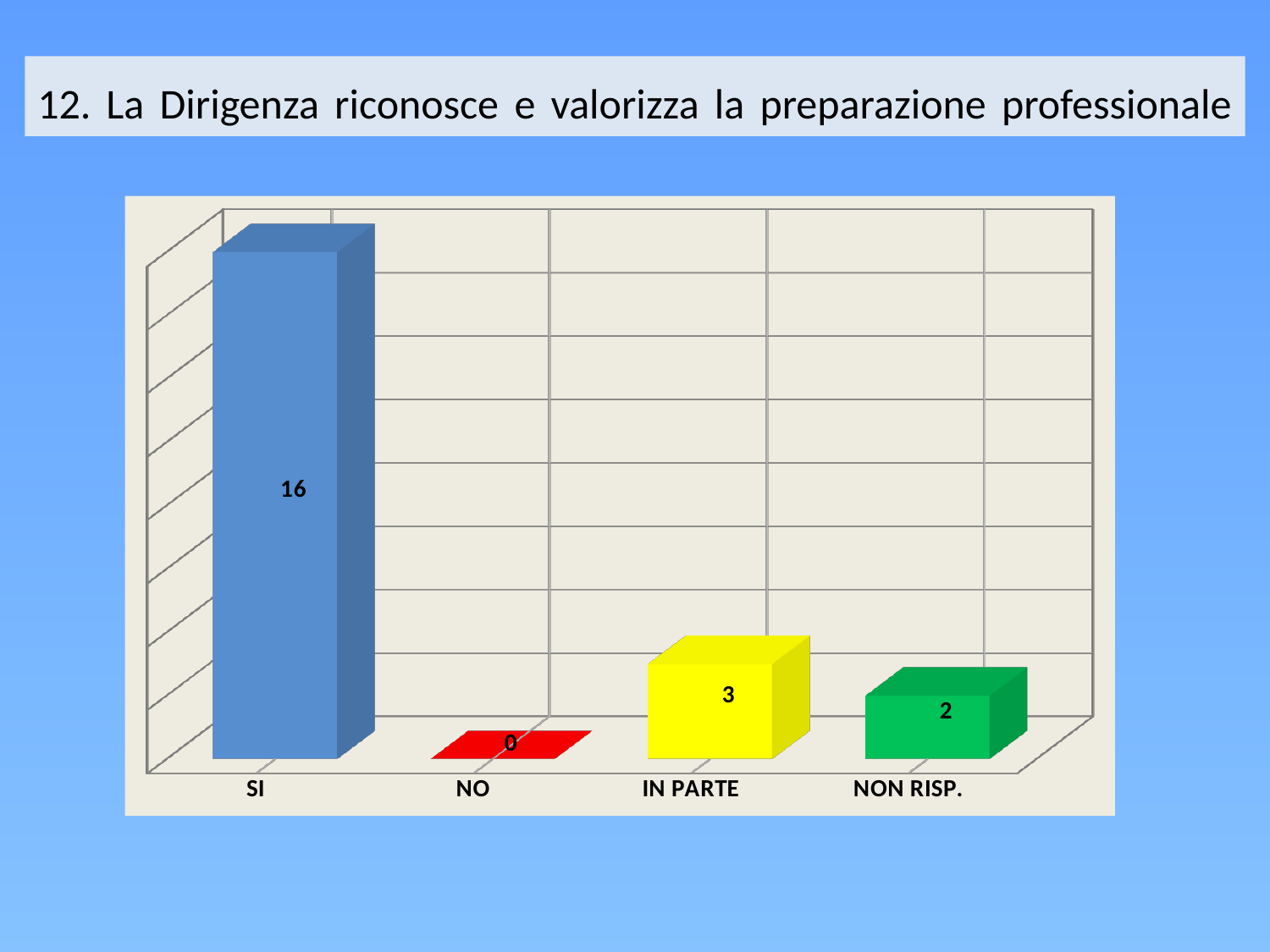
What colour is the bar for IN PARTE? yellow Which is larger, the value for IN PARTE or the value for NON RISP.? IN PARTE What is the difference between the values for IN PARTE and NON RISP.? 1 What is the value for IN PARTE? 3 Which category has the lowest value? NO What kind of chart is shown on the slide? bar chart What is the value for NON RISP.? 2 What is the value for SI? 16 What is the difference between the values for SI and IN PARTE? 13 Which category has the highest value? SI What is the value for NO? 0 How many categories are shown on the x axis? 4